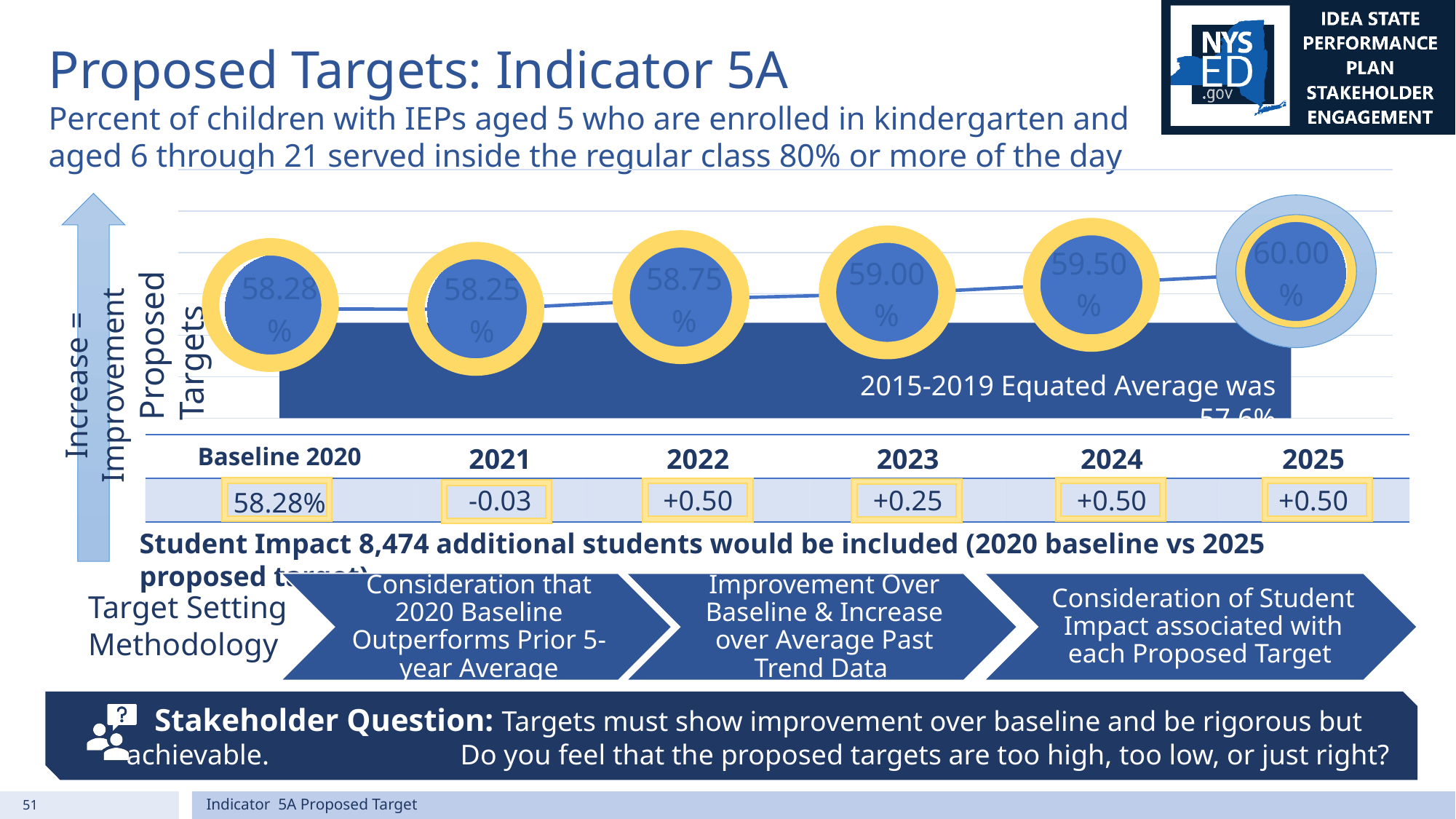
Do the proposed target values generally rise or fall from 2021 to 2025? rise What is the proposed target value for 2023? 59.00% Which year has the lowest value on the chart? 2021 What is the difference between the 2025 proposed target and the Baseline 2020 value? 1.72 What is the Baseline 2020 value shown on the chart? 58.28% Which is larger, the value for 2022 or the value for 2024? 2024 How many data points are plotted on the chart? 6 Which year has the highest proposed target value? 2025 What was the 2015-2019 Equated Average stated on the chart? 57.6% What is the proposed target value for 2021? 58.25% What is the proposed target value for 2025? 60.00% What kind of chart is used to show the proposed targets? line chart